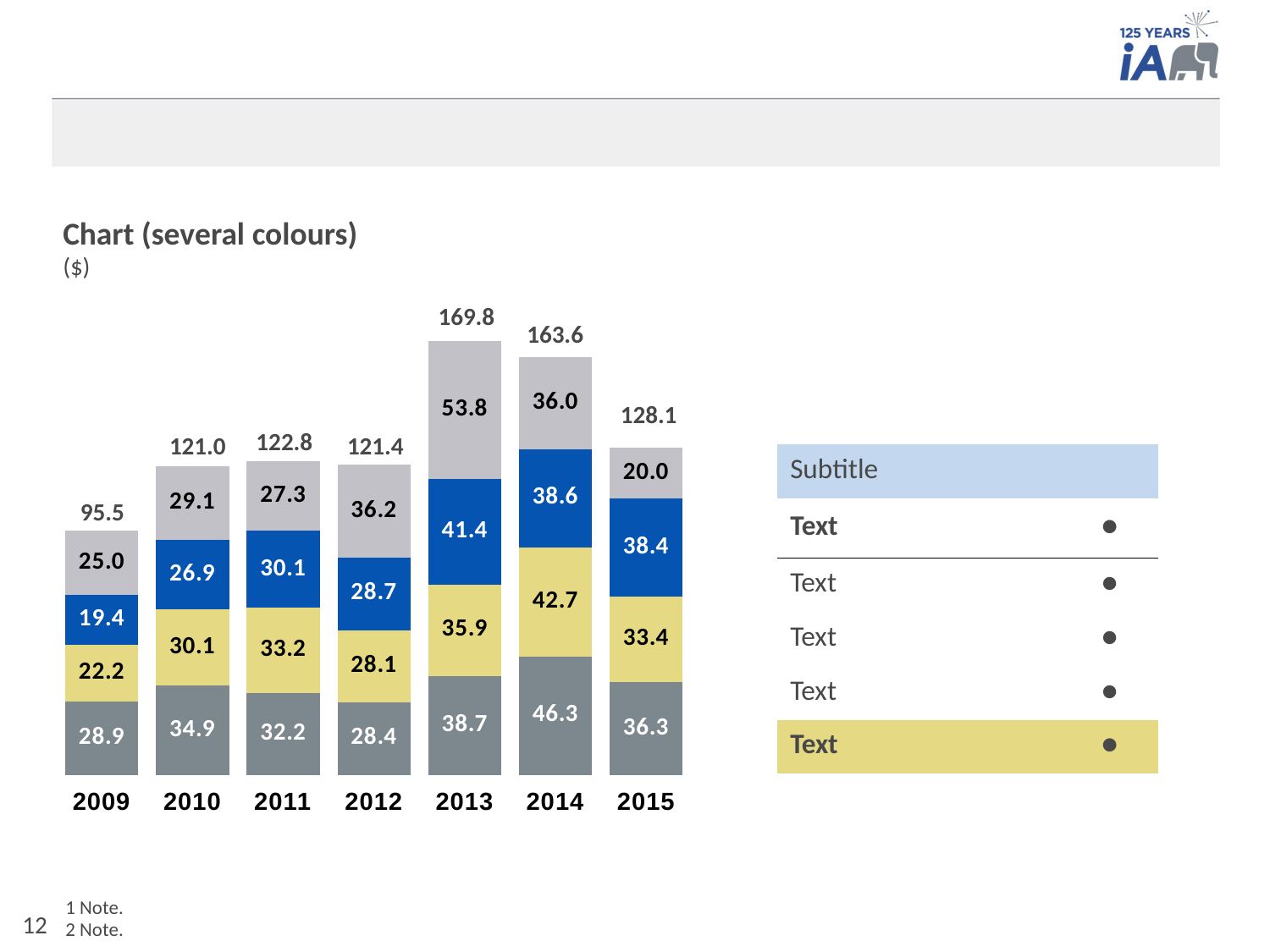
Which year has the lowest total value in the chart? 2009 Which year has the largest top light grey segment? 2013 What is the title of the chart? Chart (several colours) Which year has the highest total value in the chart? 2013 Which year has the larger yellow segment, 2011 or 2012? 2011 What is the difference between the total for 2013 and the total for 2014? 6.2 How many years are shown along the x axis of the chart? 7 What is the difference between the total for 2010 and the total for 2009? 25.5 What is the total value shown above the bar for 2015? 128.1 What is the value of the bottom dark grey segment of the 2014 bar? 46.3 What is the value of the blue segment of the 2013 bar? 41.4 What kind of chart is shown on the slide? Stacked bar chart